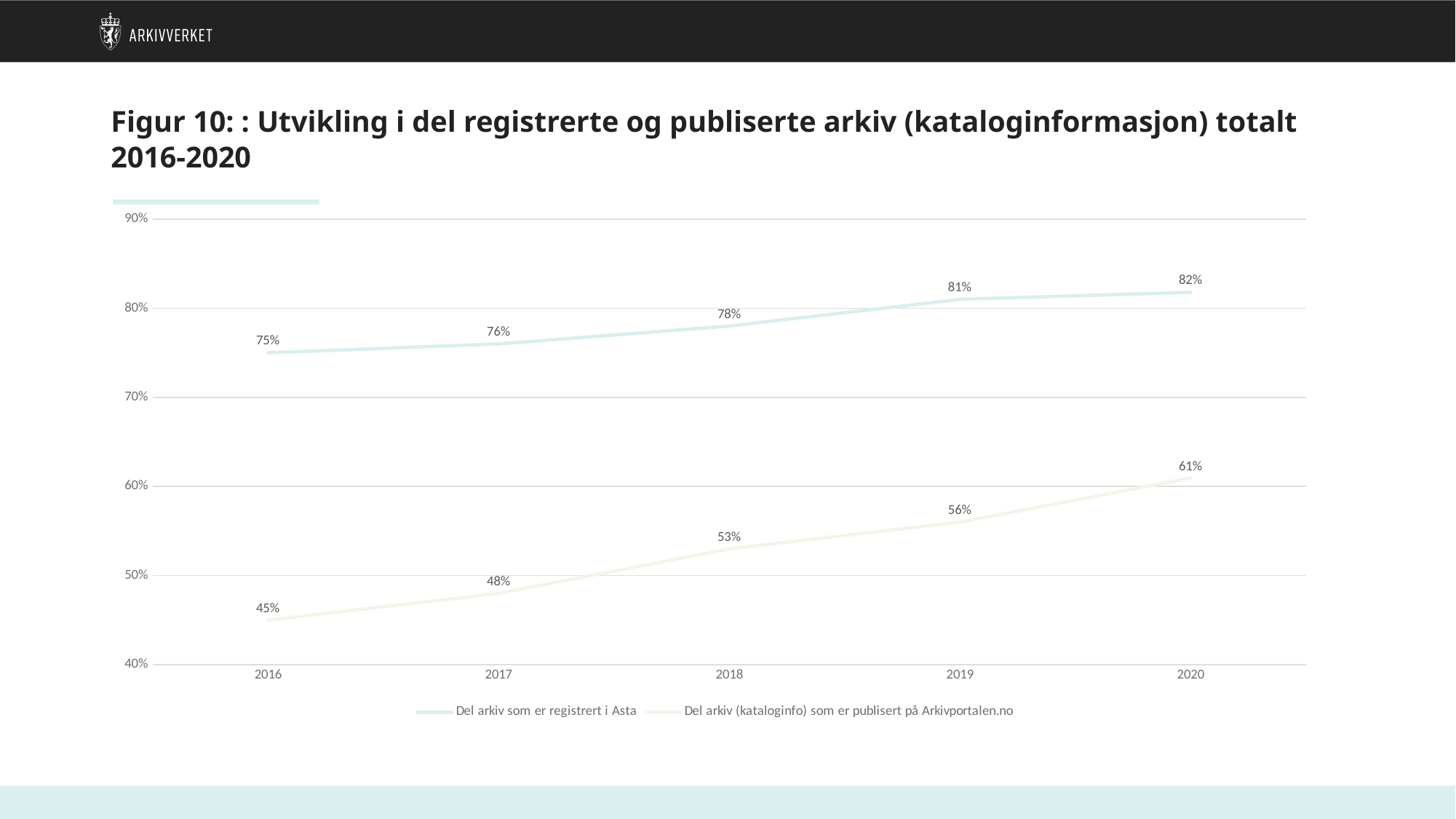
By how much did 'Del arkiv (kataloginfo) som er publisert på Arkivportalen.no' increase from 2016 to 2020? 16% What is the value for 'Del arkiv som er registrert i Asta' in 2016? 75% How many years are shown on the x axis? 5 How many series does the legend list? 2 What is the value for 'Del arkiv (kataloginfo) som er publisert på Arkivportalen.no' in 2018? 53% In which year is 'Del arkiv som er registrert i Asta' highest? 2020 In which year is 'Del arkiv (kataloginfo) som er publisert på Arkivportalen.no' lowest? 2016 What is the difference between the two series in 2020? 21% What kind of chart is this? Line chart Do the values for 'Del arkiv som er registrert i Asta' rise or fall from 2016 to 2020? Rise Which series has the higher value in 2019? Del arkiv som er registrert i Asta What is the value for 'Del arkiv (kataloginfo) som er publisert på Arkivportalen.no' in 2020? 61%